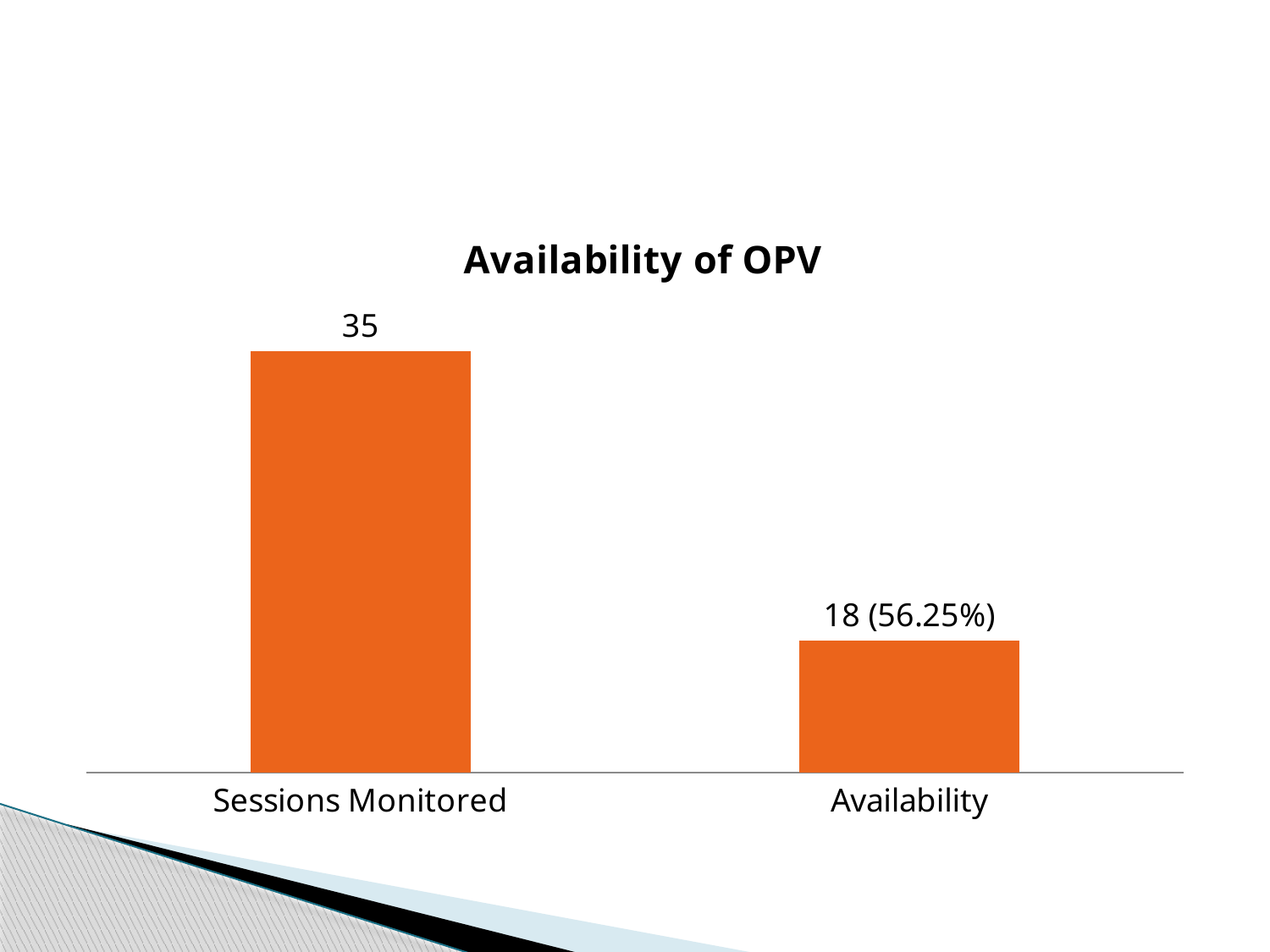
What kind of chart is shown on the slide? Bar chart What is the data label shown on the Availability bar? 18 (56.25%) What colour are the bars in the chart? Orange Which is larger, Sessions Monitored or Availability? Sessions Monitored Do the values rise or fall from left to right across the categories? Fall How many categories are shown in the chart? 2 What percentage is shown in the label for Availability? 56.25% Which category has the lowest value? Availability What is the value for Sessions Monitored? 35 What is the title of the chart? Availability of OPV What is the difference between Sessions Monitored and Availability? 17 Which category has the highest value? Sessions Monitored